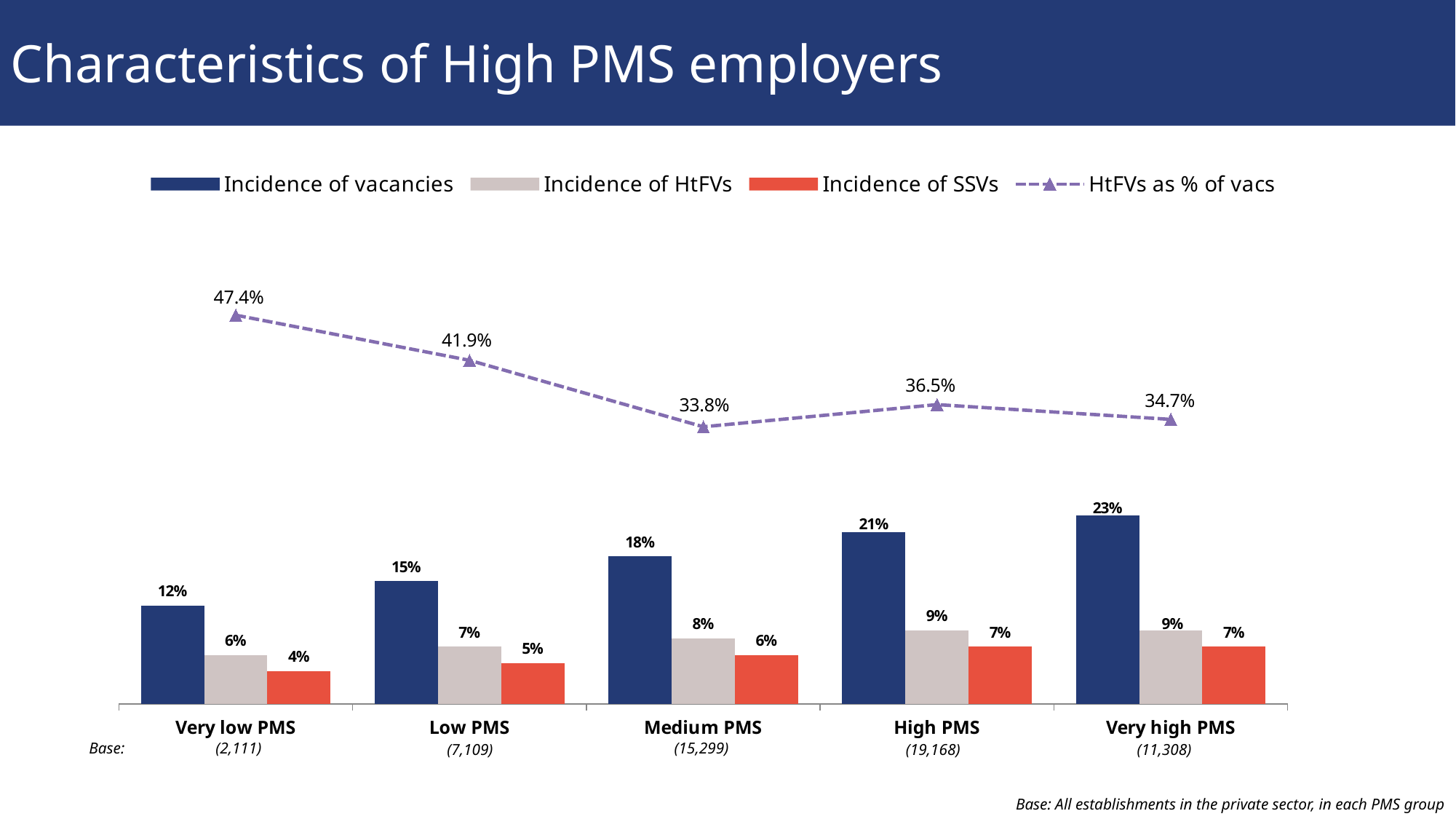
Which is larger: the Incidence of HtFVs for High PMS or for Medium PMS? High PMS What is the HtFVs as % of vacs value for Medium PMS? 33.8% What kind of chart is this? Combined bar and line chart What is the difference in Incidence of vacancies between Very high PMS and Very low PMS? 11 percentage points How many series does the legend list? 4 Does the Incidence of vacancies rise or fall from Very low PMS to Very high PMS? Rise Which PMS group has the highest HtFVs as % of vacs? Very low PMS What is the difference in HtFVs as % of vacs between Very low PMS and Low PMS? 5.5 percentage points Which PMS group has the lowest Incidence of vacancies? Very low PMS What is the Incidence of vacancies for Very high PMS? 23% What is the Incidence of SSVs for Low PMS? 5% How many PMS groups are shown on the x axis? 5